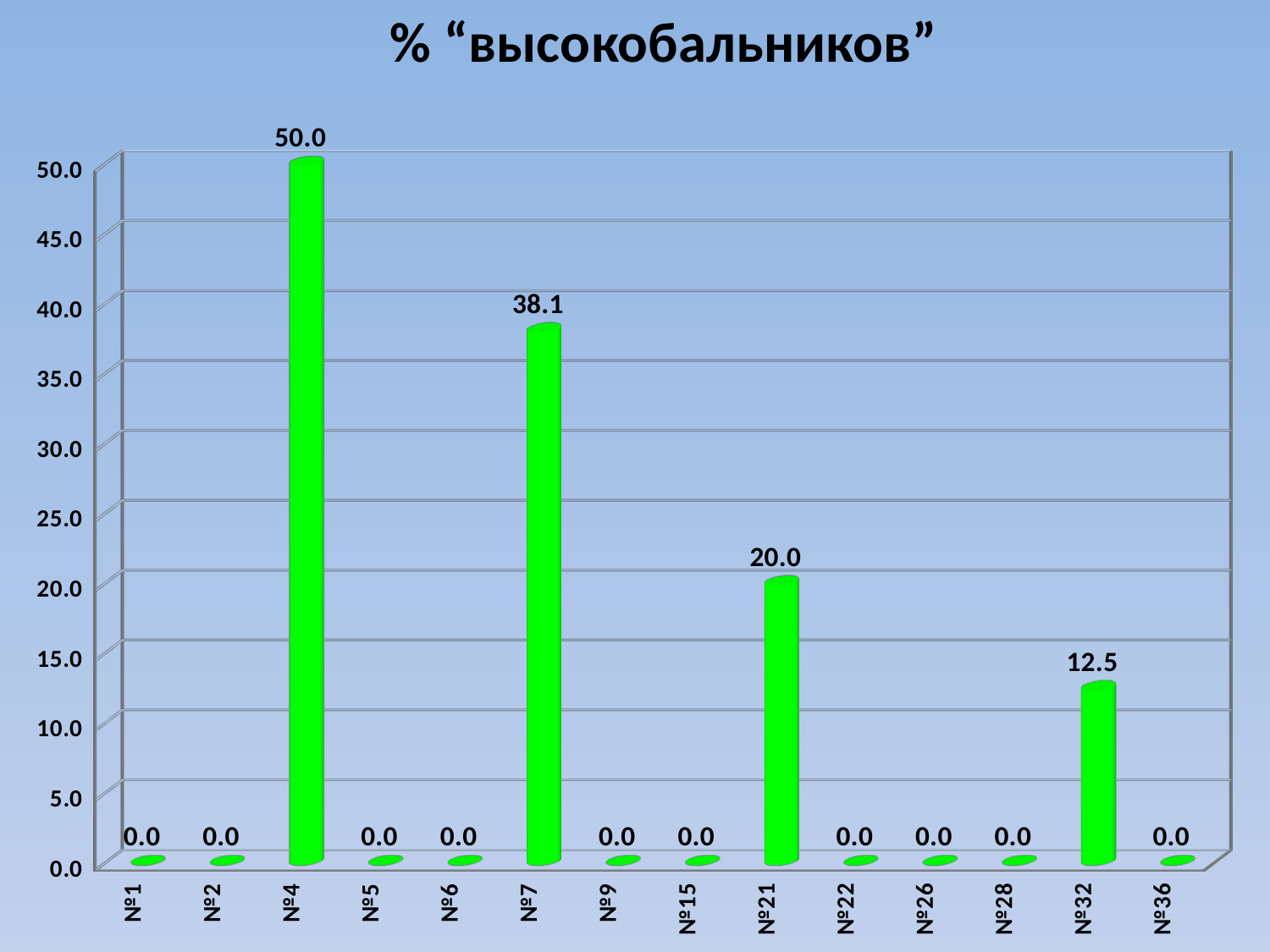
What is the value for №7? 38.1 Which is larger, the value for №7 or the value for №21? №7 What is the value for №4? 50.0 How many categories are shown on the x axis? 14 What is the title of the chart? % “высокобальников” What is the value for №32? 12.5 What kind of chart is this? bar chart What is the value for №15? 0.0 What is the difference between the values for №21 and №32? 7.5 Which category has the highest value? №4 What is the value for №21? 20.0 What is the difference between the values for №4 and №7? 11.9